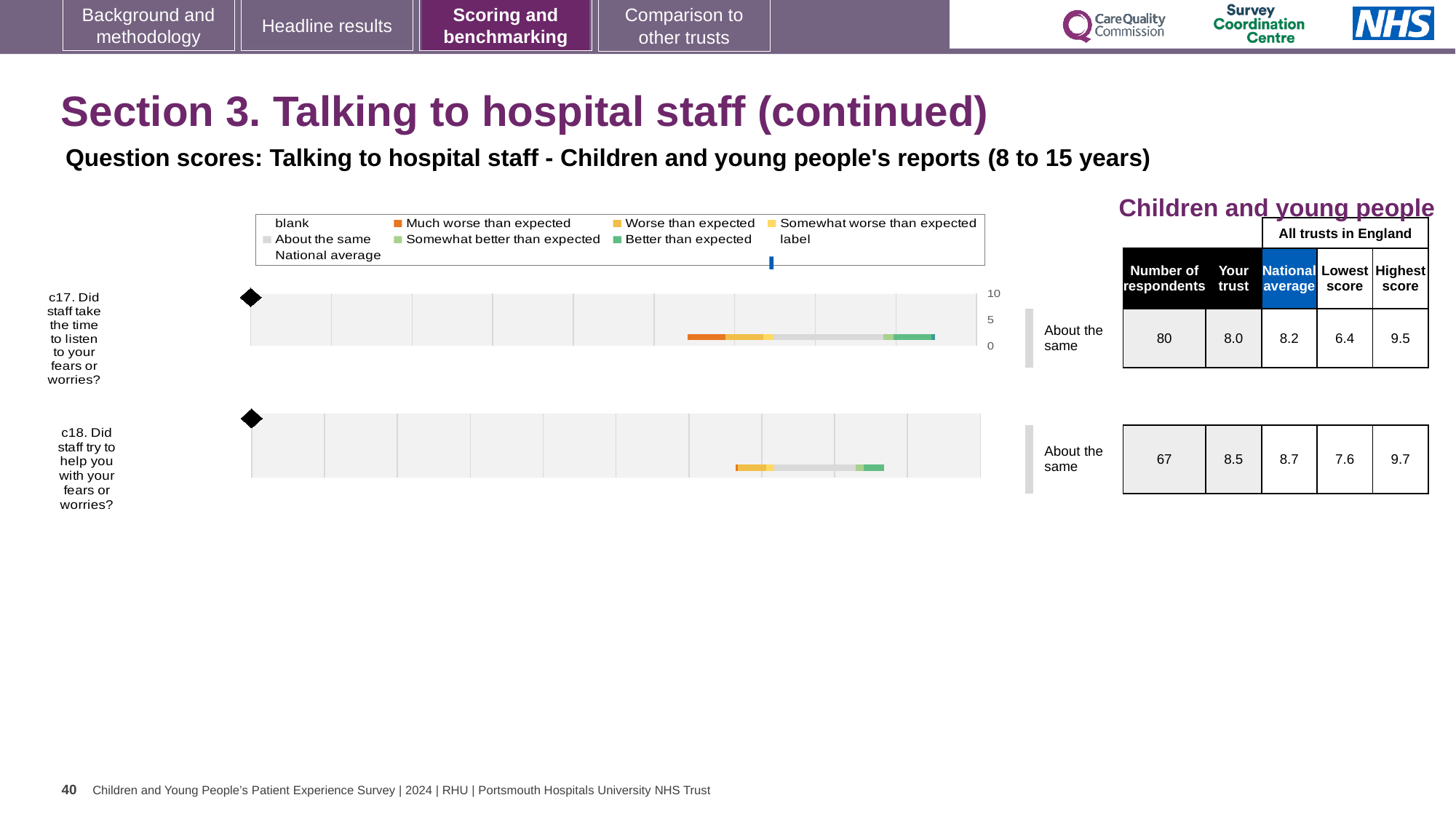
What type of chart is used to show the question scores for c17 and c18? bar chart What is the difference between the national average and the trust score for c17? 0.2 What is the 'Your trust' score for c18 (Did staff try to help you with your fears or worries?)? 8.5 What is the national average for c17? 8.2 What is the lowest score among all trusts in England for c17? 6.4 What benchmark category is shown for both c17 and c18? About the same What is the 'Your trust' score for c17 (Did staff take the time to listen to your fears or worries?)? 8.0 How many respondents answered c18? 67 Which question has the higher 'Your trust' score, c17 or c18? c18 What is the national average for c18? 8.7 How many questions (categories) are plotted on the slide? 2 What is the highest score among all trusts in England for c18? 9.7